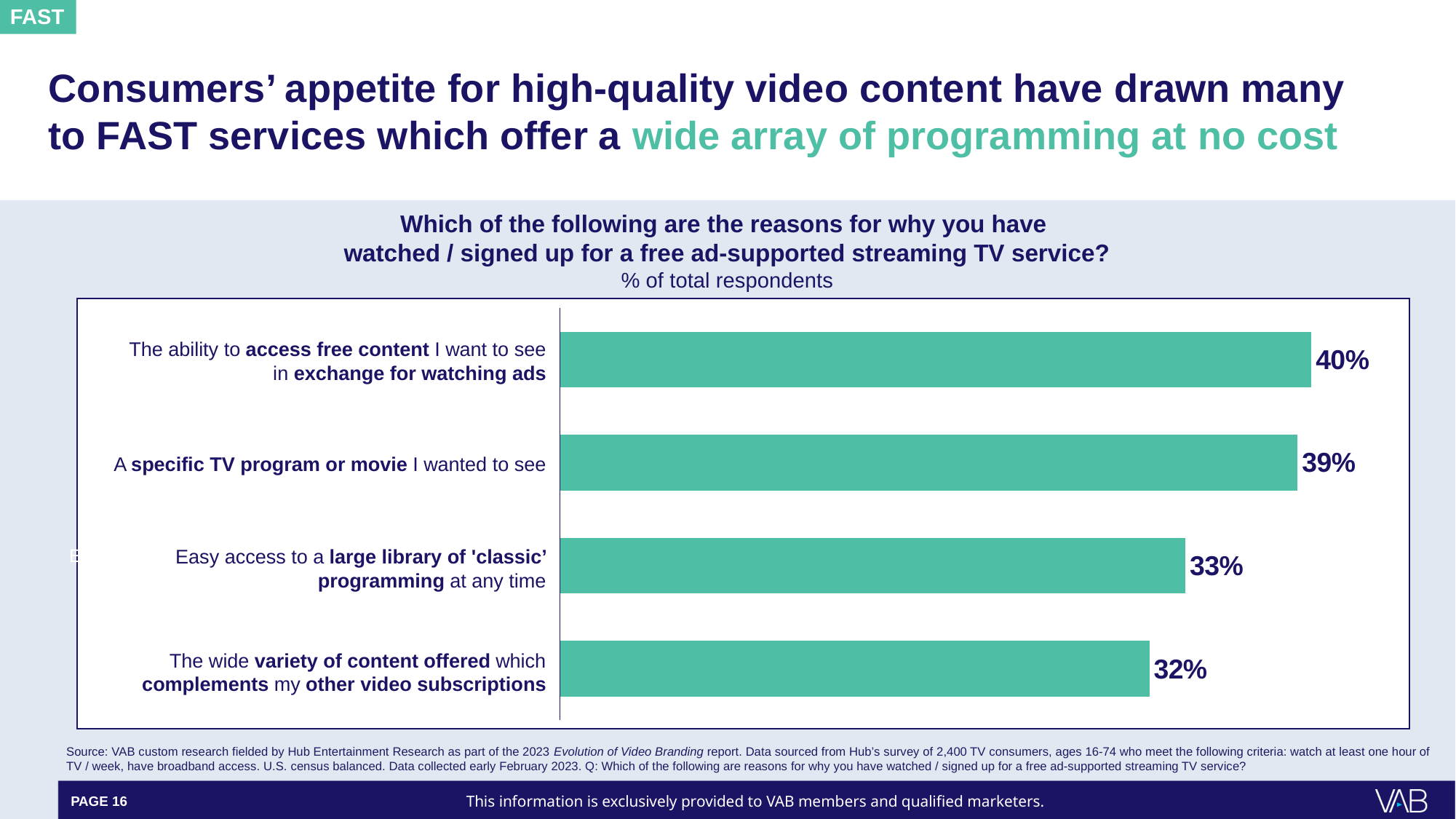
What is the difference in percentage points between the 'specific TV program or movie' reason and the 'wide variety of content' reason? 7 What percentage of respondents cited the ability to access free content in exchange for watching ads as a reason? 40% What percentage of respondents cited easy access to a large library of 'classic' programming at any time? 33% What percentage of respondents cited the wide variety of content offered which complements their other video subscriptions? 32% What is the difference in percentage points between the 'access free content' reason and the 'large library of classic programming' reason? 7 Which has a larger share of respondents: 'a specific TV program or movie I wanted to see' or 'easy access to a large library of classic programming'? A specific TV program or movie I wanted to see What type of chart is shown on the slide? Bar chart What percentage of respondents cited a specific TV program or movie they wanted to see? 39% What unit is the chart measured in, according to the subtitle? % of total respondents Which reason has the highest percentage of respondents? The ability to access free content I want to see in exchange for watching ads Which reason has the lowest percentage of respondents? The wide variety of content offered which complements my other video subscriptions How many reasons are shown in the chart? 4